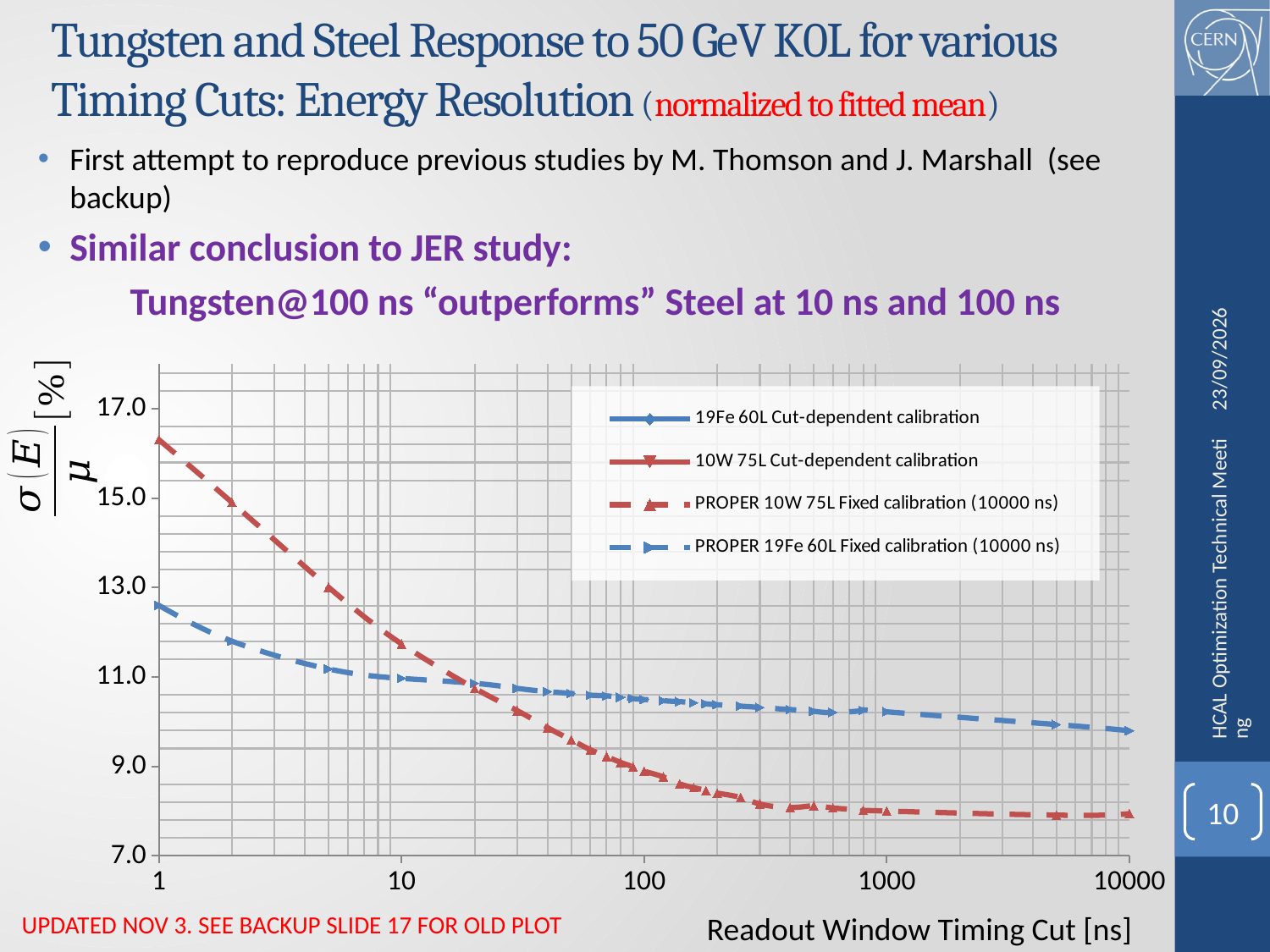
Is the value of the PROPER 19Fe 60L Fixed calibration (10000 ns) series at a timing cut of 1 ns greater or less than 13.0? less Is the value of the PROPER 19Fe 60L Fixed calibration (10000 ns) series at a timing cut of 10000 ns greater or less than 9.0? greater Which legend entry is drawn with a solid blue line? 19Fe 60L Cut-dependent calibration Does the PROPER 10W 75L Fixed calibration (10000 ns) series rise or fall as the timing cut increases from 1 ns to 10000 ns? fall Is the value of the PROPER 10W 75L Fixed calibration (10000 ns) series at a timing cut of 1 ns greater or less than 15.0? greater At a timing cut of 10000 ns, which series has the higher value: PROPER 10W 75L Fixed calibration or PROPER 19Fe 60L Fixed calibration? PROPER 19Fe 60L Fixed calibration (10000 ns) At a timing cut of 1 ns, which series has the higher value: PROPER 10W 75L Fixed calibration or PROPER 19Fe 60L Fixed calibration? PROPER 10W 75L Fixed calibration (10000 ns) How many series does the chart legend list? 4 Does the PROPER 19Fe 60L Fixed calibration (10000 ns) series rise or fall as the timing cut increases from 1 ns to 10000 ns? fall What kind of chart is shown on the slide? line chart What is the label of the x axis of the chart? Readout Window Timing Cut [ns]